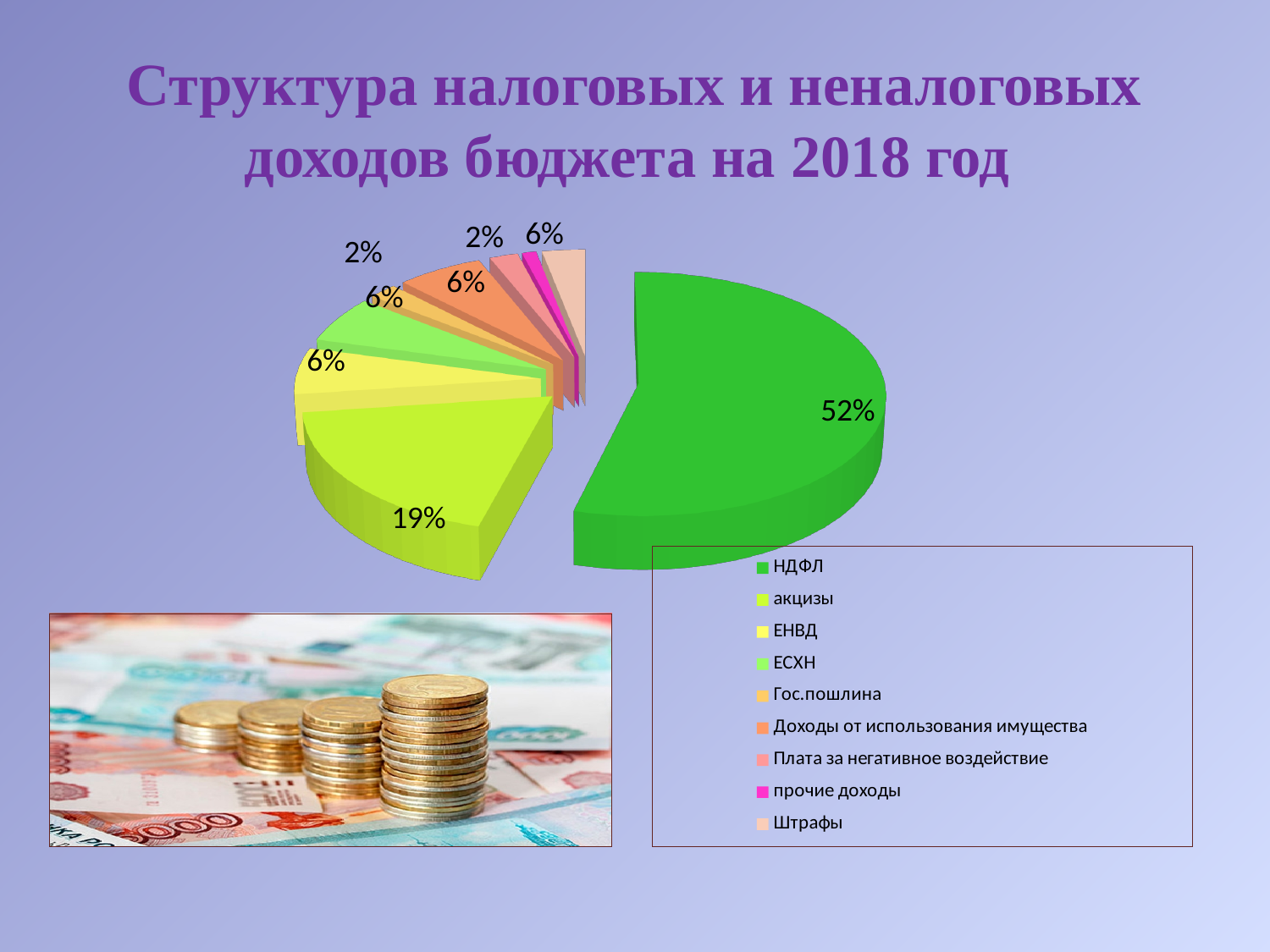
What is the value shown for ЕСХН? 6% How many categories does the legend list? 9 Which category has the largest slice of the pie? НДФЛ What type of chart is shown on the slide? pie chart What is the value shown for акцизы? 19% Which legend entry is shown in green? НДФЛ What is the difference between the share for НДФЛ and the share for акцизы? 33 percentage points What share of the pie does НДФЛ account for? 52% Is the share for НДФЛ greater or less than half of the pie? greater What is the title of the slide containing the chart? Структура налоговых и неналоговых доходов бюджета на 2018 год What is the value shown for ЕНВД? 6% Which is larger, the share for НДФЛ or the share for акцизы? НДФЛ